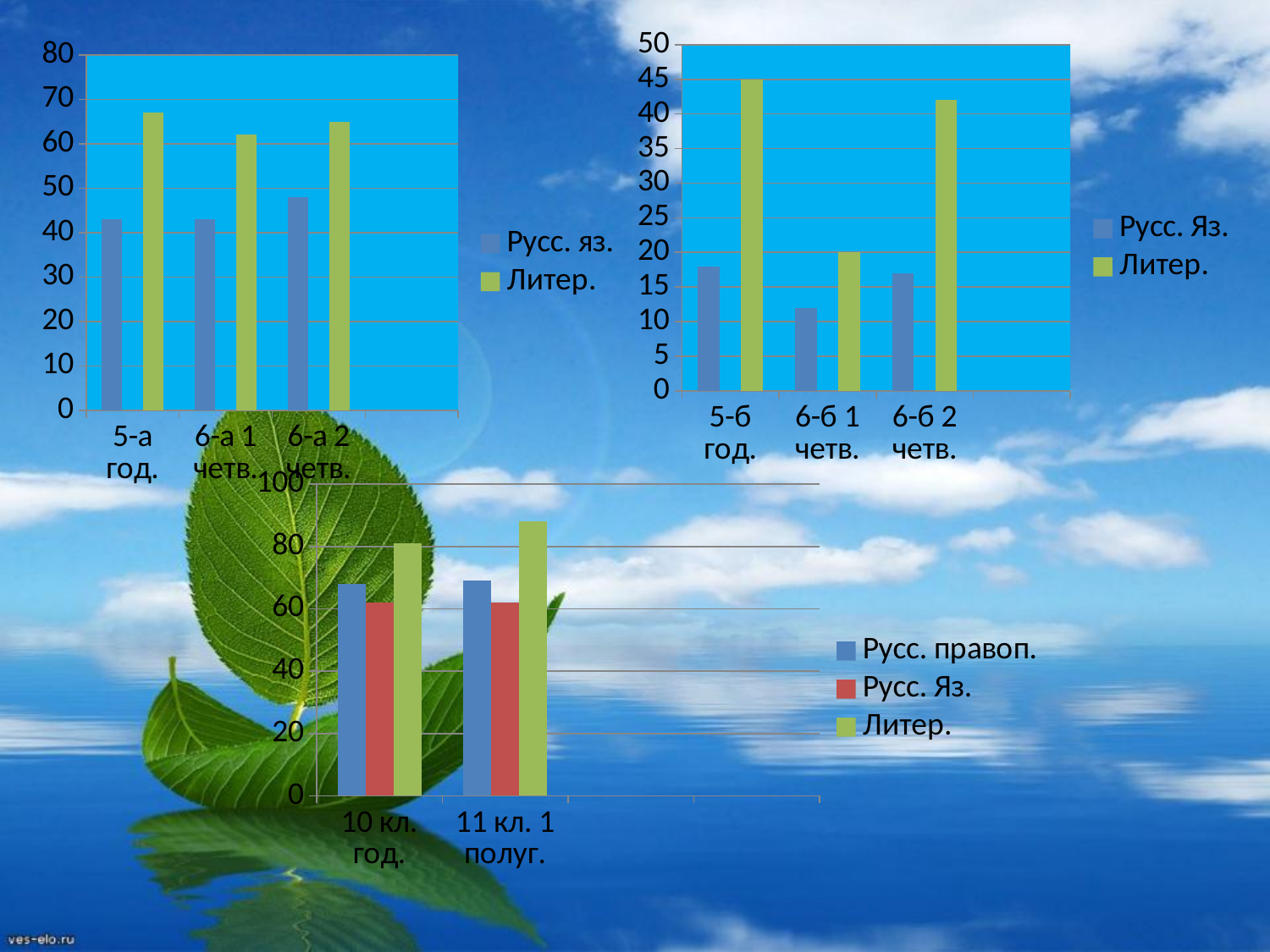
In the top-left chart, is the value of Литер. for 6-а 1 четв. greater or less than 50? greater In the top-right chart, which category has the lowest value for Литер.? 6-б 1 четв. In the top-left chart, which category has the highest value for Русс. яз.? 6-а 2 четв. In the top-right chart, is the value of Русс. Яз. for 6-б 1 четв. greater or less than 15? less In the top-right chart, is the value of Литер. for 5-б год. greater or less than 40? greater In the top-left chart, how many series does the legend list? 2 What kind of chart is the bottom chart? bar chart In the bottom chart, how many series does the legend list? 3 In the bottom chart, which series has the highest value for 10 кл. год.? Литер. In the top-right chart, for 5-б год., which is larger: Русс. Яз. or Литер.? Литер. In the top-left chart, how many categories are shown on the x axis? 3